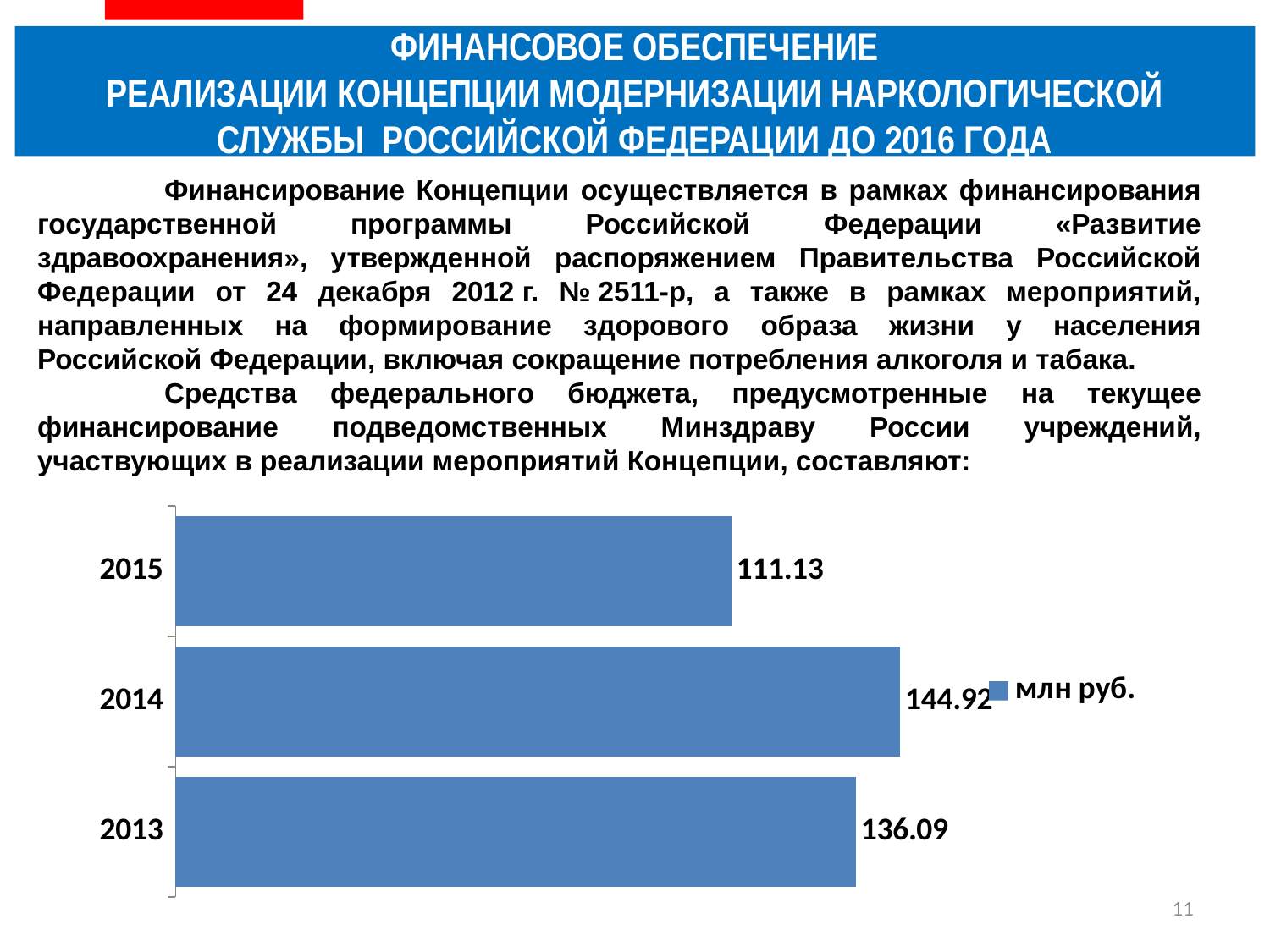
Which year has the lowest value? 2015 What is the value for 2014? 144.92 How many series does the legend list? 1 How many years are shown in the chart? 3 What is the difference between the values for 2013 and 2015? 24.96 What is the value for 2015? 111.13 Which year has the highest value? 2014 What is the legend entry of the chart? млн руб. What is the difference between the values for 2014 and 2013? 8.83 What kind of chart is shown on the slide? bar chart What is the value for 2013? 136.09 Which is larger, the value for 2013 or the value for 2015? 2013